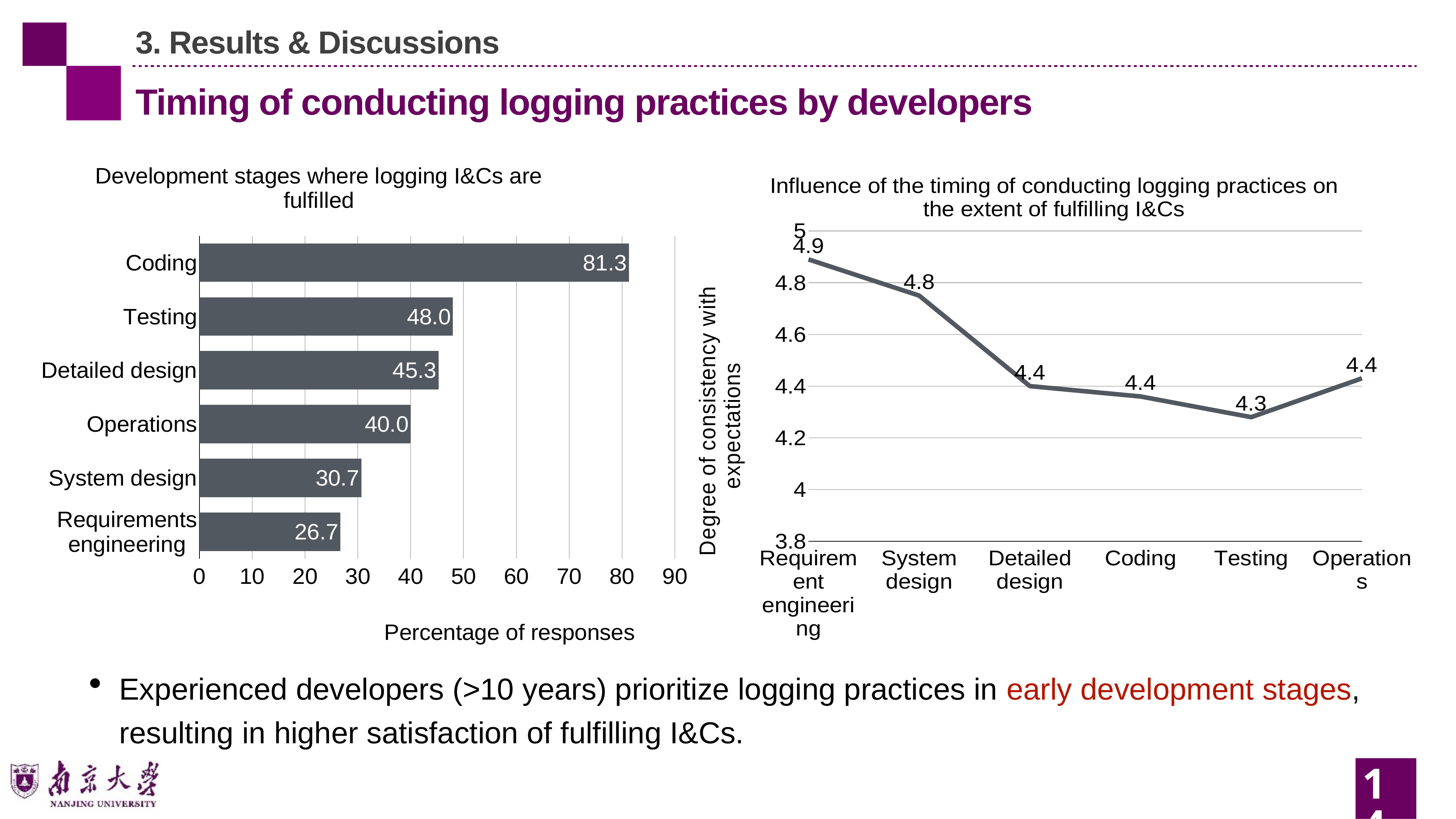
What kind of chart is the chart titled "Development stages where logging I&Cs are fulfilled"? Bar chart In the chart titled "Influence of the timing of conducting logging practices on the extent of fulfilling I&Cs", what is the value for Requirement engineering? 4.9 In the chart titled "Development stages where logging I&Cs are fulfilled", which development stage has the lowest percentage of responses? Requirements engineering In the chart titled "Influence of the timing of conducting logging practices on the extent of fulfilling I&Cs", what is the value for Testing? 4.3 In the chart titled "Development stages where logging I&Cs are fulfilled", how many development stages are shown? 6 In the chart titled "Development stages where logging I&Cs are fulfilled", which development stage has the highest percentage of responses? Coding In the chart titled "Influence of the timing of conducting logging practices on the extent of fulfilling I&Cs", is the value for System design larger than the value for Coding? Yes In the chart titled "Influence of the timing of conducting logging practices on the extent of fulfilling I&Cs", which stage has the lowest degree of consistency with expectations? Testing In the chart titled "Development stages where logging I&Cs are fulfilled", what is the value for Coding? 81.3 In the chart titled "Development stages where logging I&Cs are fulfilled", what is the difference between the values for Coding and Testing? 33.3 In the chart titled "Development stages where logging I&Cs are fulfilled", what is the value for Requirements engineering? 26.7 What kind of chart is the chart titled "Influence of the timing of conducting logging practices on the extent of fulfilling I&Cs"? Line chart